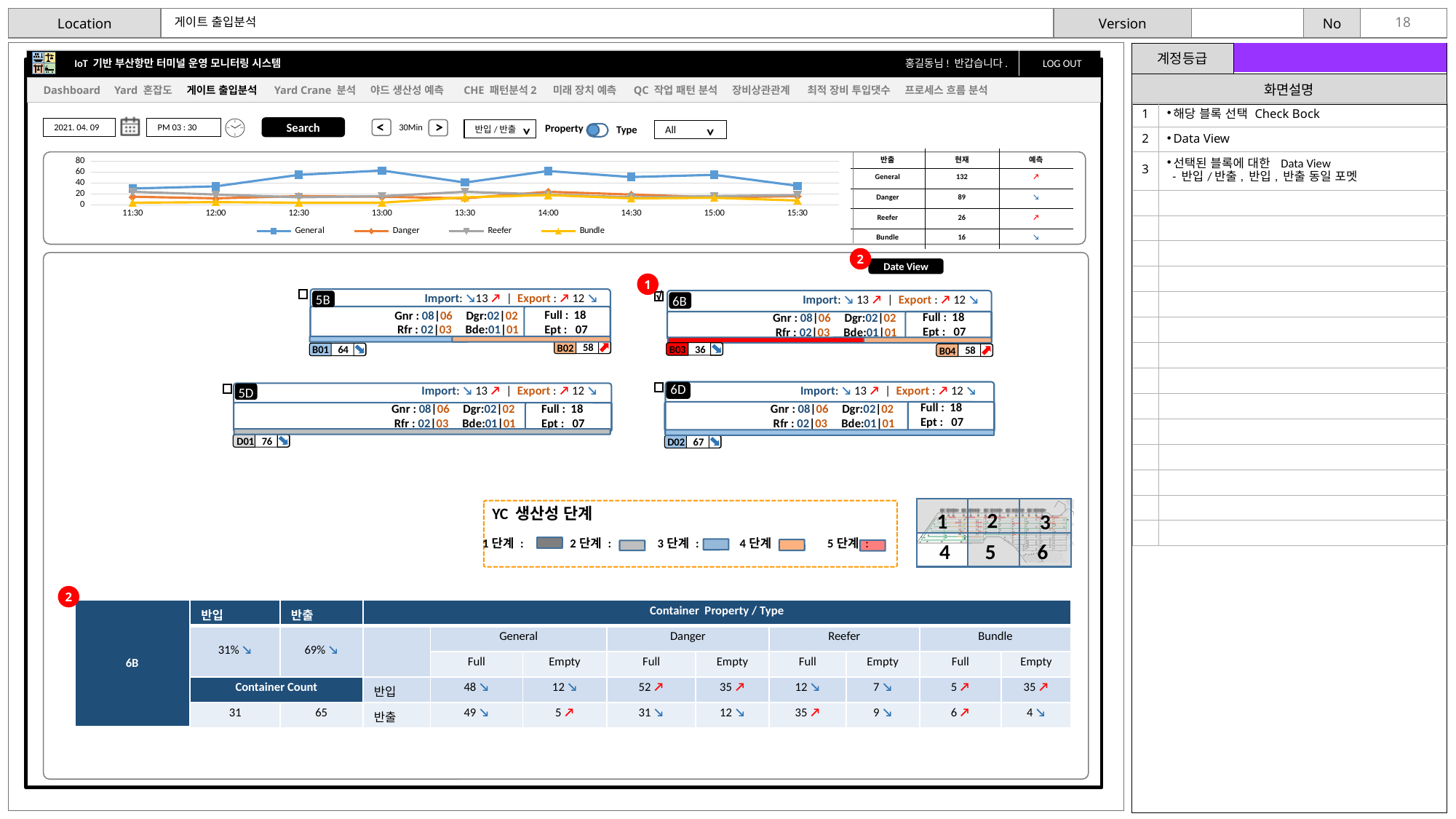
In the top line chart, is the value for General at 13:00 greater or less than 40? greater In the top line chart, does the General series rise or fall from 12:00 to 13:00? rise How many series does the legend of the top line chart list? 4 How many time points are shown on the x axis of the top line chart? 9 In the top line chart, which series has the highest values across the time points? General What colour is the General series in the top line chart? blue What kind of chart is shown at the top of the slide? line chart In the top line chart, is the value for General at 11:30 greater or less than 60? less In the top line chart, is the value for Danger at 14:00 greater or less than 40? less What are the legend entries of the top line chart, from left to right? General, Danger, Reefer, Bundle In the top line chart, which is larger at 13:00, General or Bundle? General In the top line chart, which series has the lowest value at 11:30? Bundle